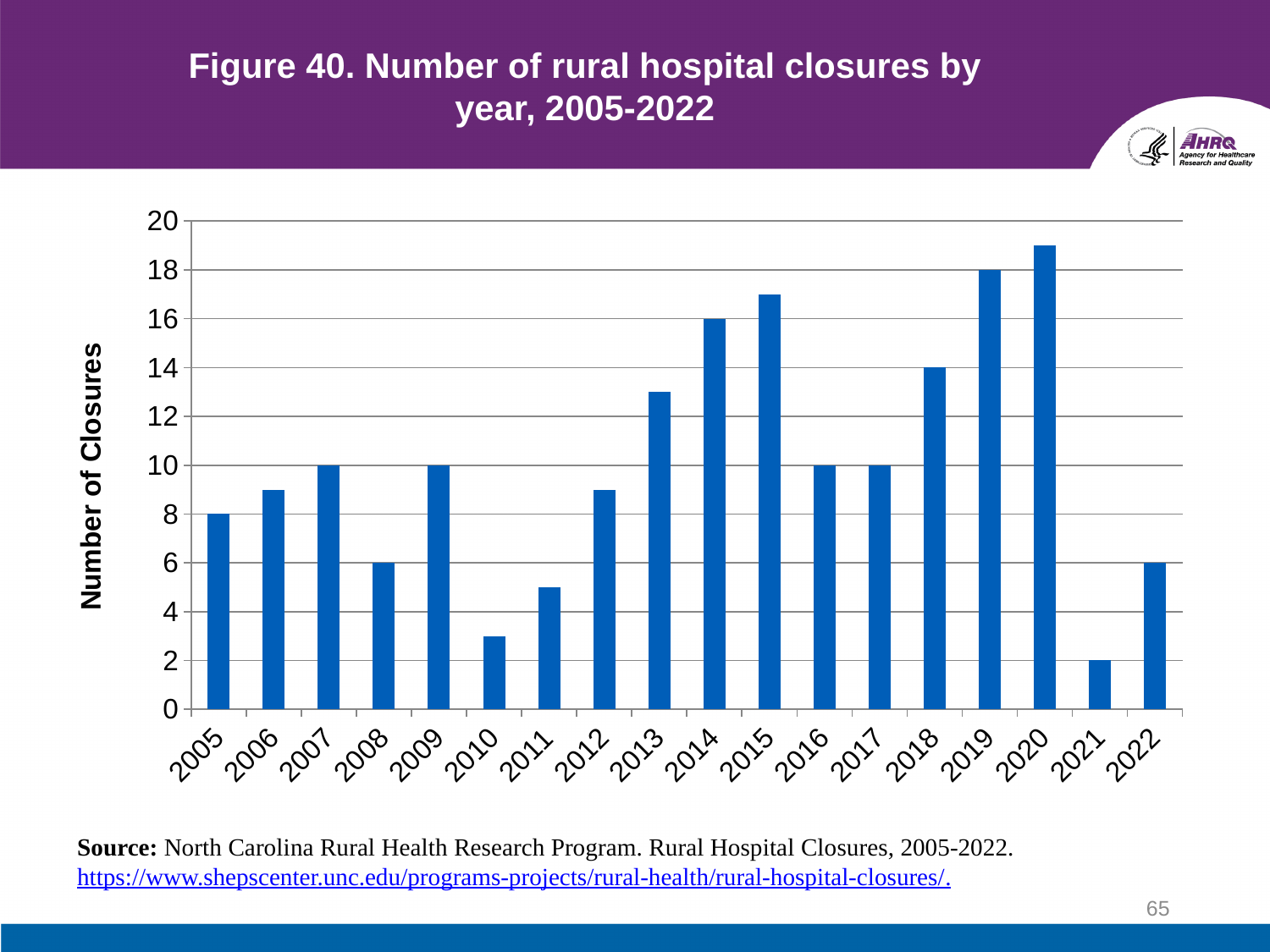
Which year had the lowest number of rural hospital closures? 2021 Which year had more closures, 2014 or 2016? 2014 How many rural hospital closures were there in 2019? 18 How many rural hospital closures were there in 2021? 2 Do the values rise or fall from 2019 to 2021? fall What is the difference between the number of closures in 2019 and in 2021? 16 Is the value for 2010 greater or less than 4? less What kind of chart is shown on the slide? bar chart How many years are plotted on the x axis? 18 How many rural hospital closures were there in 2018? 14 Is the value for 2015 greater or less than 16? greater Which year had the highest number of rural hospital closures? 2020